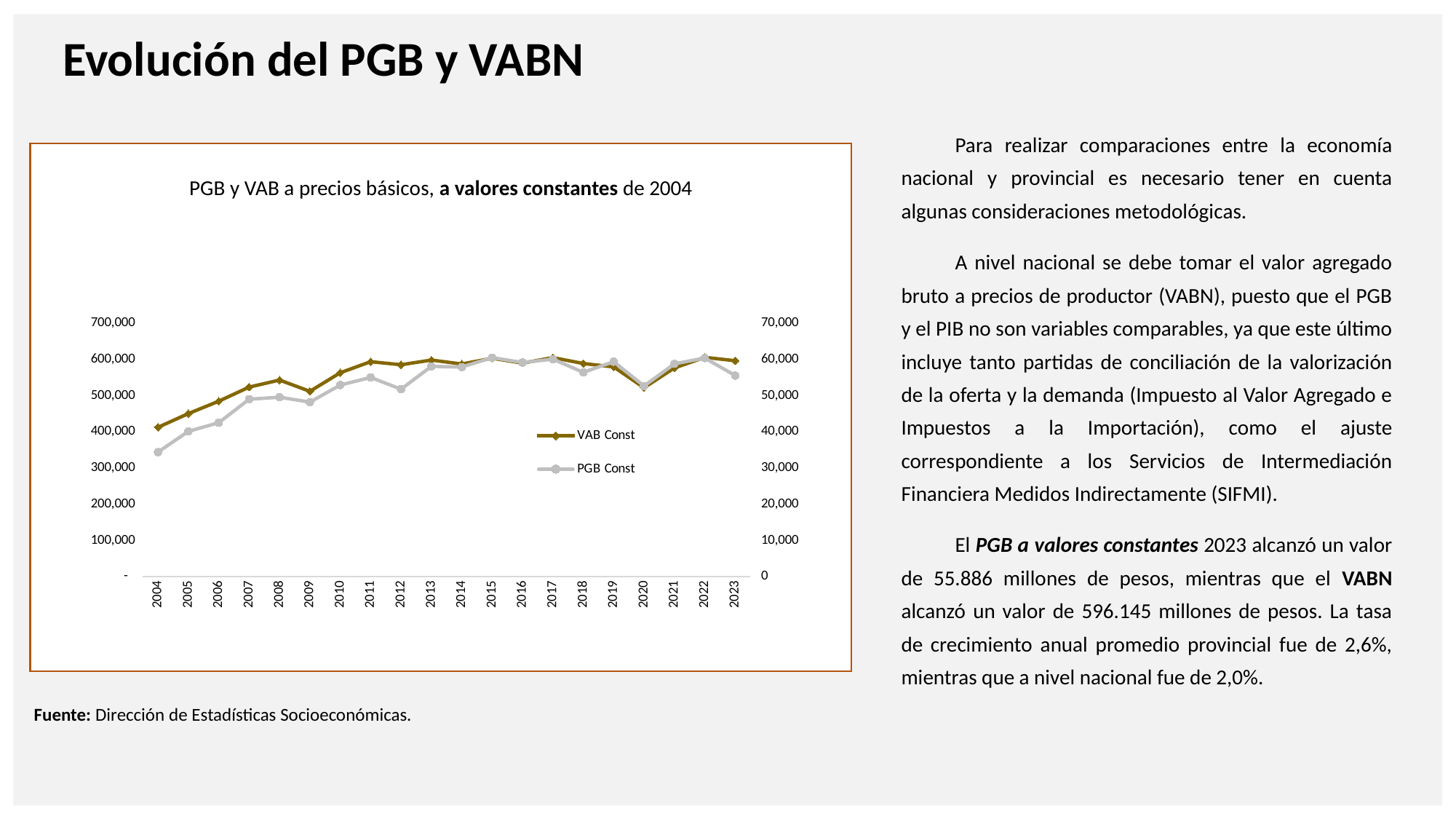
What are the two series named in the chart legend? VAB Const and PGB Const In which year is the VAB Const series at its lowest value? 2004 How many years are plotted along the x axis of the chart? 20 How many series does the chart legend list? 2 In which year is the PGB Const series at its lowest value? 2004 What kind of chart is shown on the slide? line chart What is the title of the chart? PGB y VAB a precios básicos, a valores constantes de 2004 Which is larger for the VAB Const series: the value in 2004 or the value in 2011? 2011 Is the PGB Const value for 2004 greater or less than 40,000 on the right axis? less Is the VAB Const value for 2004 greater or less than 500,000? less Does the VAB Const series rise or fall between 2004 and 2011? rise Is the VAB Const value for 2023 greater or less than 500,000? greater